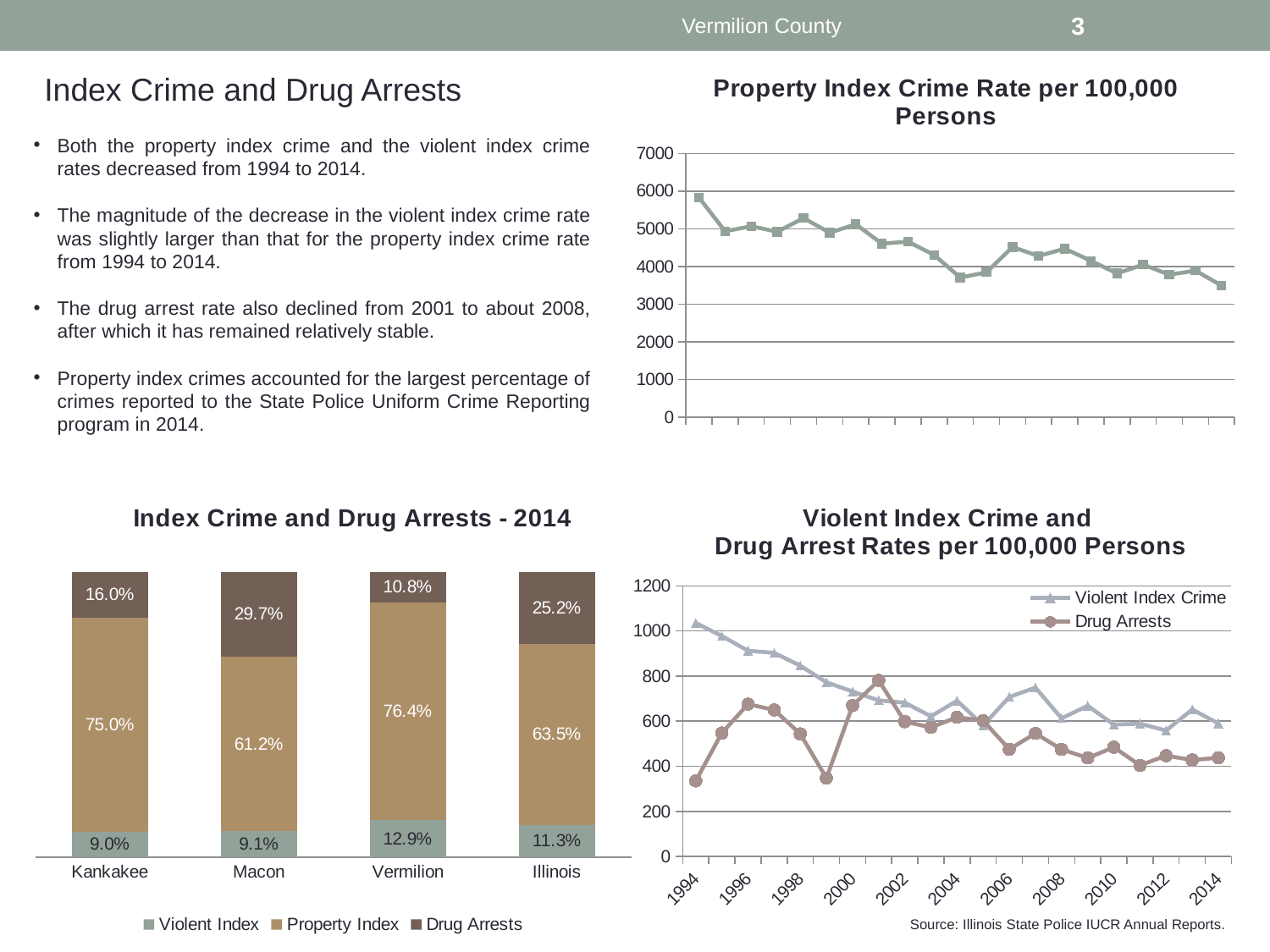
How many categories are shown on the x axis of the 'Index Crime and Drug Arrests - 2014' chart? 4 In the 'Index Crime and Drug Arrests - 2014' chart, which category has the highest Property Index percentage? Vermilion What kind of chart is 'Index Crime and Drug Arrests - 2014'? Stacked bar chart In the 'Violent Index Crime and Drug Arrest Rates per 100,000 Persons' chart, does the Violent Index Crime line generally rise or fall from 1994 to 2014? fall In the 'Index Crime and Drug Arrests - 2014' chart, what percentage does Property Index account for in Vermilion? 76.4% In the 'Index Crime and Drug Arrests - 2014' chart, what is the Drug Arrests percentage for Macon? 29.7% How many series does the legend of the 'Index Crime and Drug Arrests - 2014' chart list? 3 In the 'Index Crime and Drug Arrests - 2014' chart, how much larger is the Drug Arrests percentage for Macon than for Kankakee? 13.7 percentage points How many series does the legend of the 'Violent Index Crime and Drug Arrest Rates per 100,000 Persons' chart list? 2 In the 'Violent Index Crime and Drug Arrest Rates per 100,000 Persons' chart, is the Violent Index Crime value for 1994 greater or less than 1000? greater In the 'Property Index Crime Rate per 100,000 Persons' chart, is the last plotted point greater or less than 4000? less In the 'Index Crime and Drug Arrests - 2014' chart, which category has the lowest Violent Index percentage? Kankakee